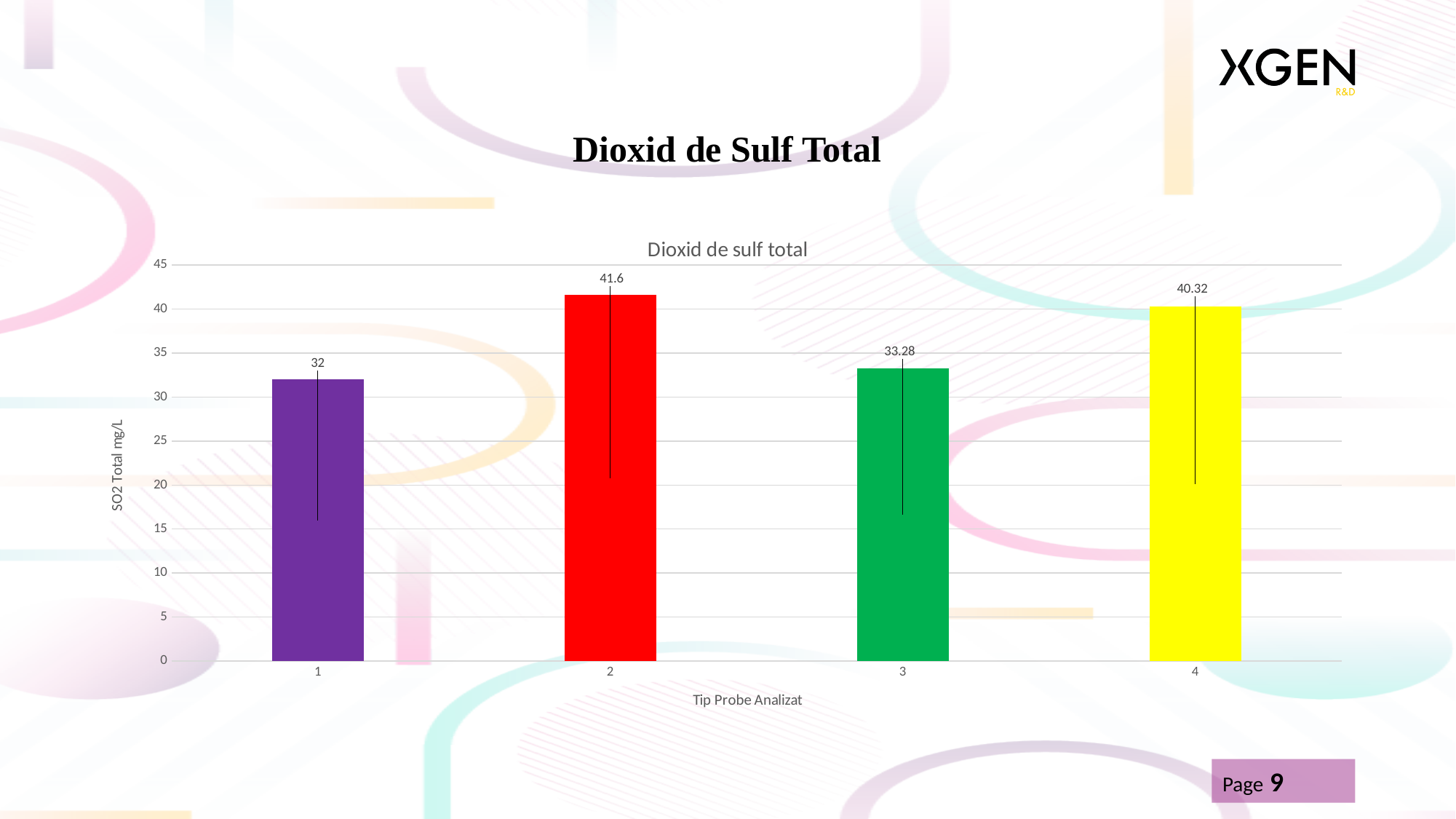
Is the value for sample type 3 greater or less than 35? less What kind of chart is shown on the slide? bar chart Which has a larger SO2 Total value, sample type 3 or sample type 4? 4 What is the SO2 Total value for sample type 3? 33.28 Which sample type has the lowest SO2 Total value? 1 What is the label of the vertical axis of the chart? SO2 Total mg/L How many sample types are plotted in the chart? 4 Which sample type has the highest SO2 Total value? 2 What is the SO2 Total value for sample type 1? 32 What is the SO2 Total value for sample type 4? 40.32 What is the difference between the SO2 Total values for sample types 2 and 1? 9.6 What is the SO2 Total value for sample type 2? 41.6